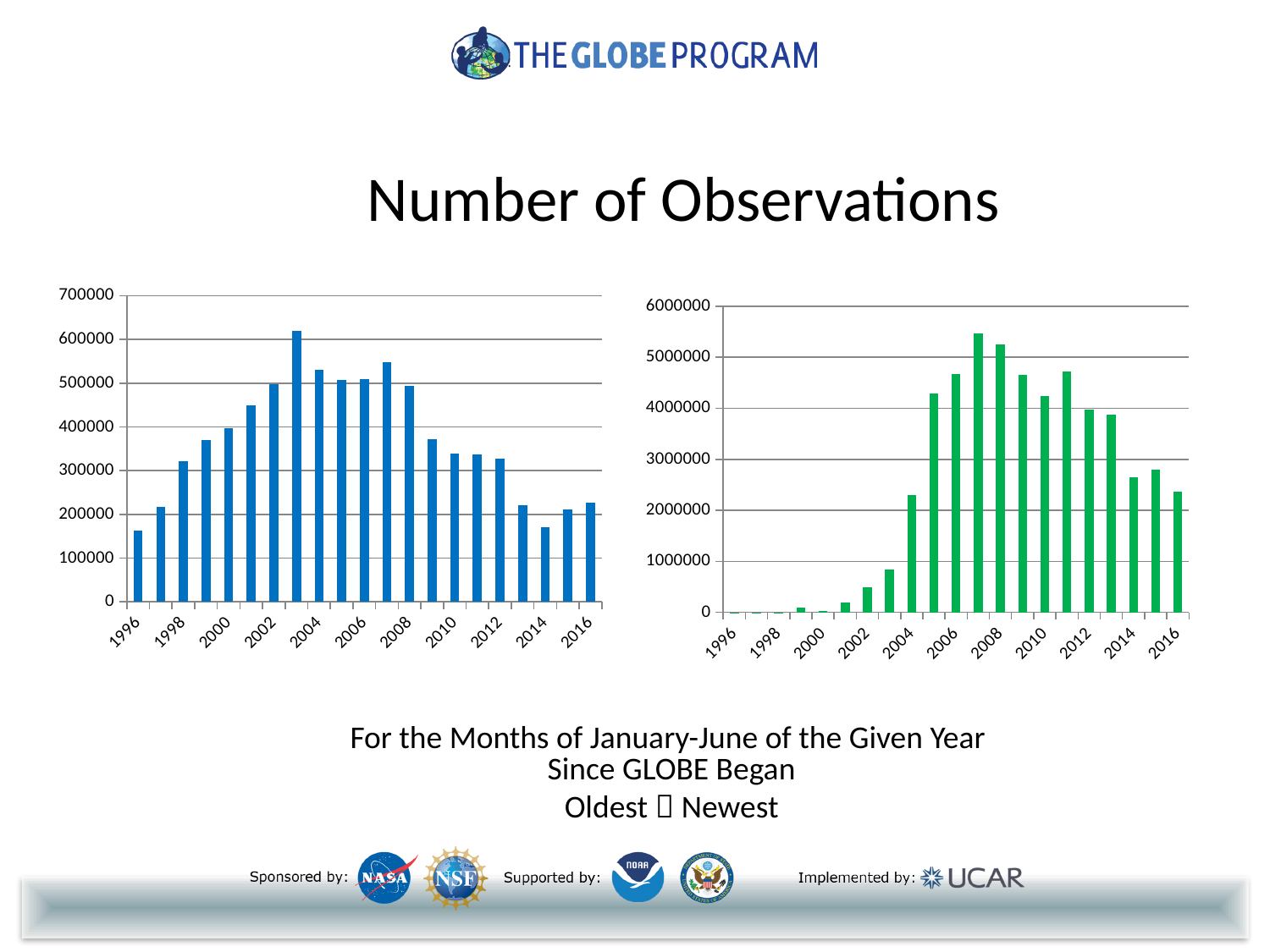
In the right chart, do the values rise or fall from 2011 to 2016? fall In the right chart, which year has the larger value, 2007 or 2008? 2007 In the left chart, which year has the highest number of observations? 2003 In the right chart, which year has the highest number of observations? 2007 In the right chart, is the value for 2016 greater or less than 3000000? less What kind of chart is the right chart on the slide? bar chart What kind of chart is the left chart on the slide? bar chart In the right chart, is the value for 2007 greater or less than 5000000? greater In the left chart, is the value for 2003 greater or less than 600000? greater What colour are the bars in the right chart? green In the left chart, which year has the lowest number of observations? 1996